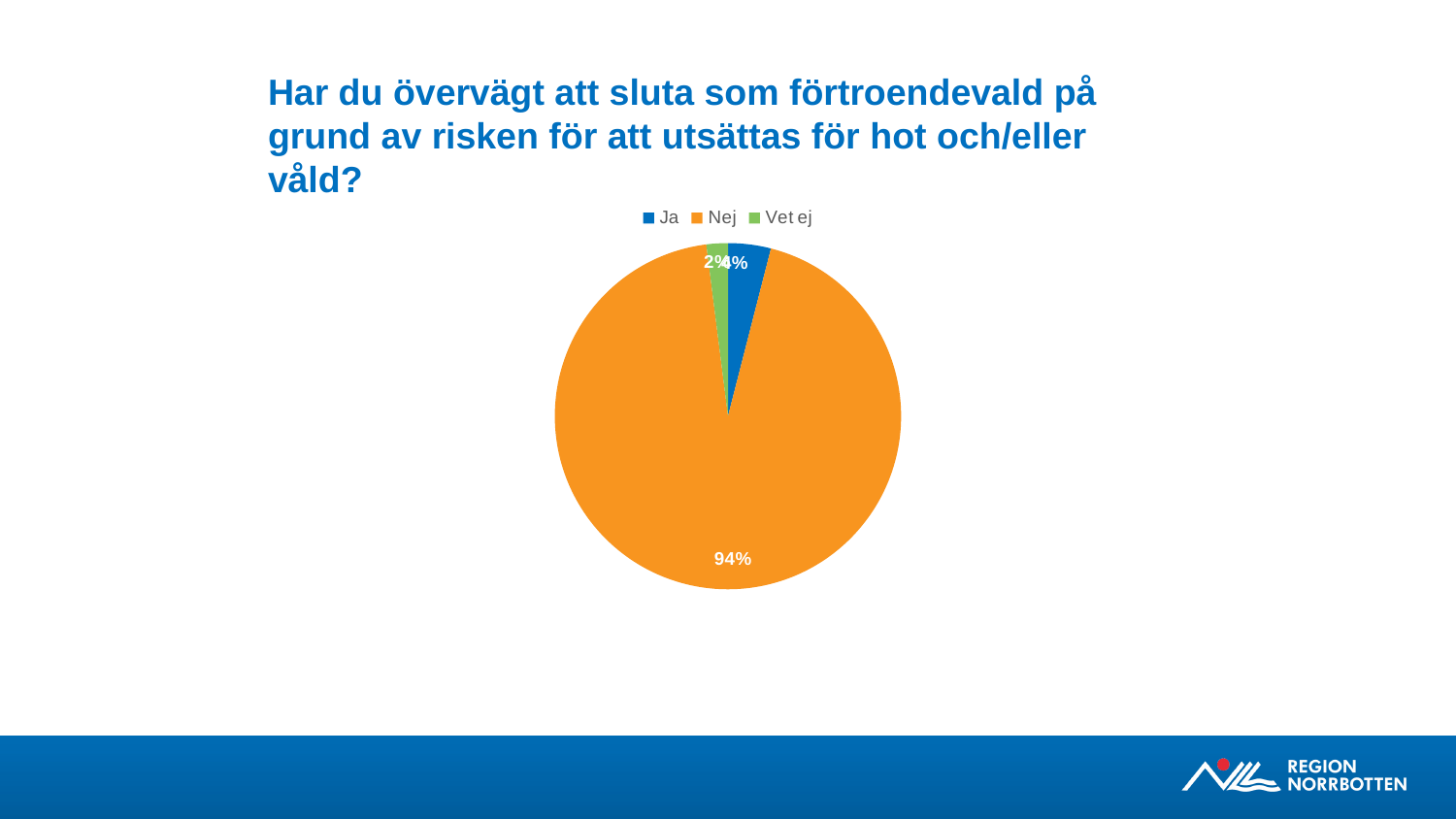
Which category has the smallest slice of the pie? Vet ej What are the three legend entries of the pie chart? Ja, Nej, Vet ej How many entries does the legend list? 3 What is the value shown for "Ja"? 4% What colour is the "Nej" slice? orange How many categories does the pie chart have? 3 What is the value shown for "Vet ej"? 2% What share of the pie does "Nej" have? 94% Which category has the largest slice of the pie? Nej Which slice is larger, "Ja" or "Vet ej"? Ja Which slice is larger, "Nej" or "Ja"? Nej What kind of chart is shown on the slide? pie chart